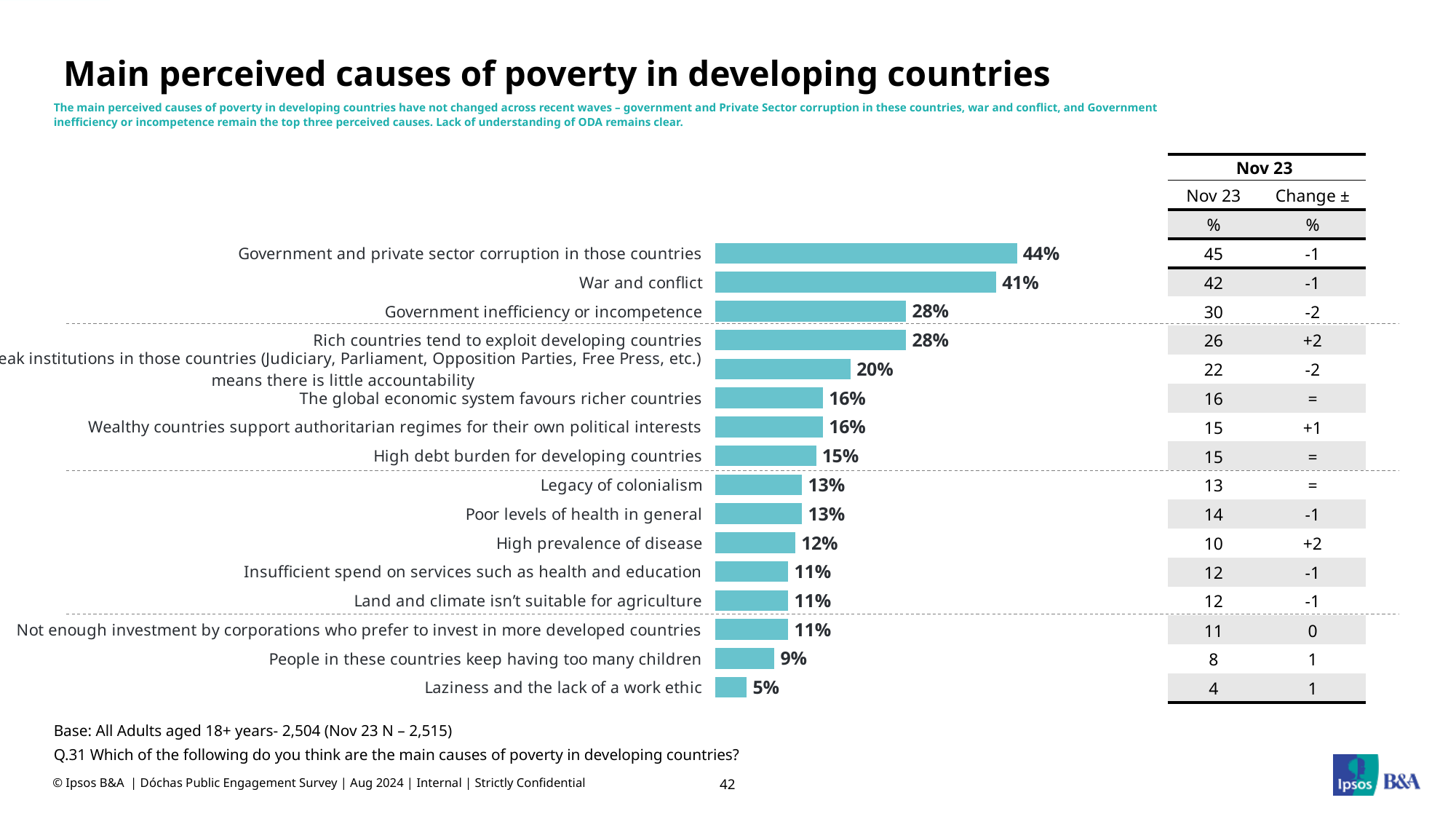
What is the difference in percentage points between 'Government and private sector corruption in those countries' and 'War and conflict'? 3 Which perceived cause of poverty has the highest percentage in the chart? Government and private sector corruption in those countries What is the value shown for 'High debt burden for developing countries'? 15% What is the difference in percentage points between 'Government inefficiency or incompetence' and 'Legacy of colonialism'? 15 What percentage of respondents cited 'War and conflict' as a main cause of poverty in developing countries? 41% What is the title of the slide containing the chart? Main perceived causes of poverty in developing countries Which has a higher value: 'The global economic system favours richer countries' or 'Poor levels of health in general'? The global economic system favours richer countries How many perceived causes of poverty are listed in the bar chart? 16 What type of chart is used to show the perceived causes of poverty? Bar chart What is the value shown for 'Laziness and the lack of a work ethic'? 5% Which perceived cause of poverty has the lowest percentage in the chart? Laziness and the lack of a work ethic Which has a higher value: 'High prevalence of disease' or 'People in these countries keep having too many children'? High prevalence of disease